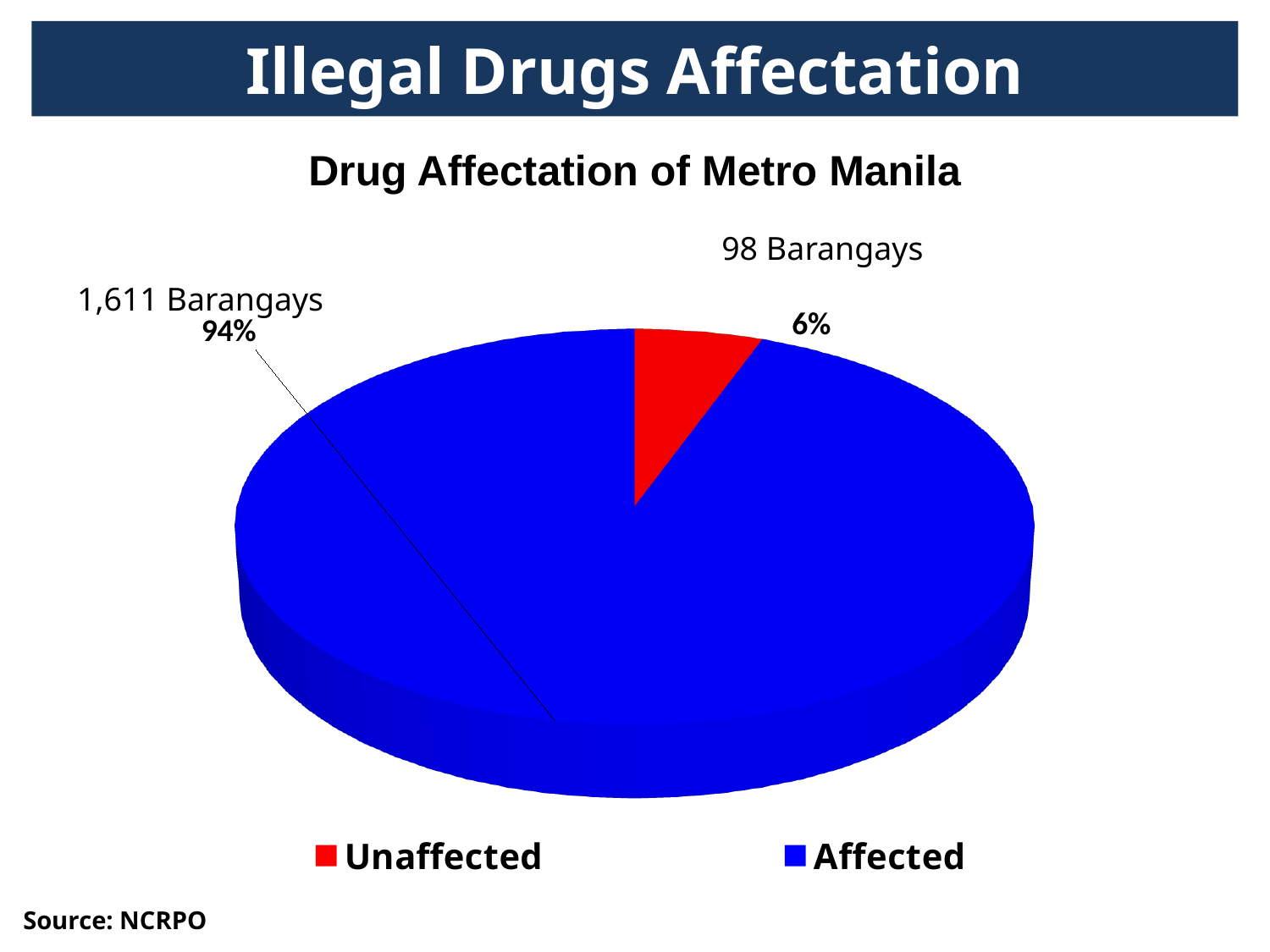
What share of the pie is the Unaffected slice? 6% How many slices does the pie chart have? 2 How many barangays are labelled as Unaffected? 98 Barangays What type of chart is shown on the slide? Pie chart Which category has the smallest slice? Unaffected What colour represents the Unaffected category? Red Which is larger, the Affected slice or the Unaffected slice? Affected What share of the pie is the Affected slice? 94% How many barangays are labelled as Affected? 1,611 Barangays Which category has the largest slice? Affected What is the title of the chart? Drug Affectation of Metro Manila How many categories does the legend list? 2